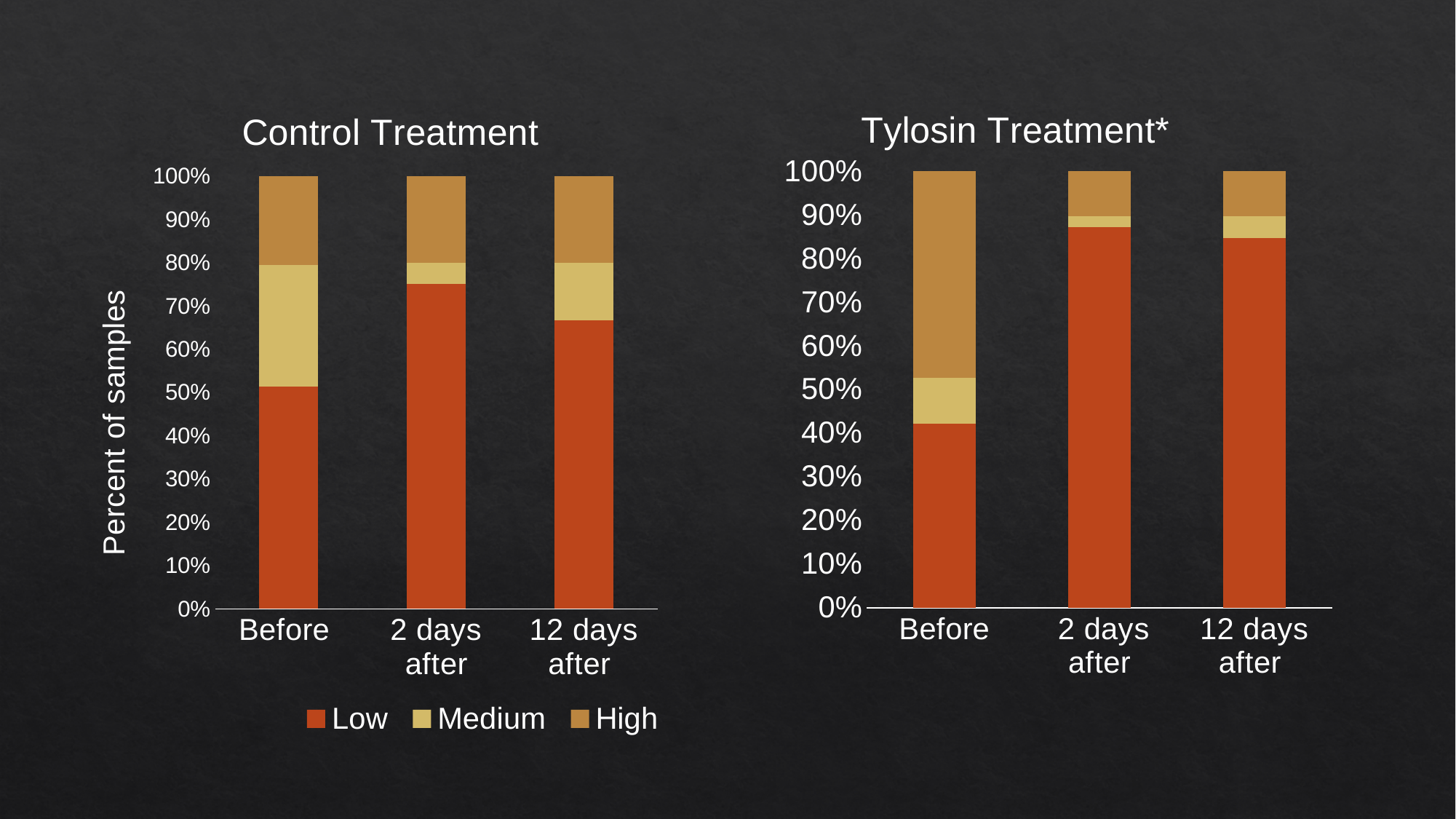
In the Tylosin Treatment* chart, is the Low share for 2 days after greater or less than 80%? greater In the Control Treatment chart, which has the larger Low share: Before or 2 days after? 2 days after How many time-point categories are shown on the x axis of the Tylosin Treatment* chart? 3 In the Control Treatment chart, which time point has the largest Low share? 2 days after In the Tylosin Treatment* chart, which has the larger High share: Before or 12 days after? Before In the Control Treatment chart, is the Low share for 2 days after greater or less than 70%? greater What kind of chart is the Control Treatment chart? Stacked bar chart What is the y-axis title of the Control Treatment chart? Percent of samples In the Control Treatment chart, is the Low share for Before greater or less than 60%? less How many series does the legend list? 3 In the Tylosin Treatment* chart, which time point has the smallest Low share? Before